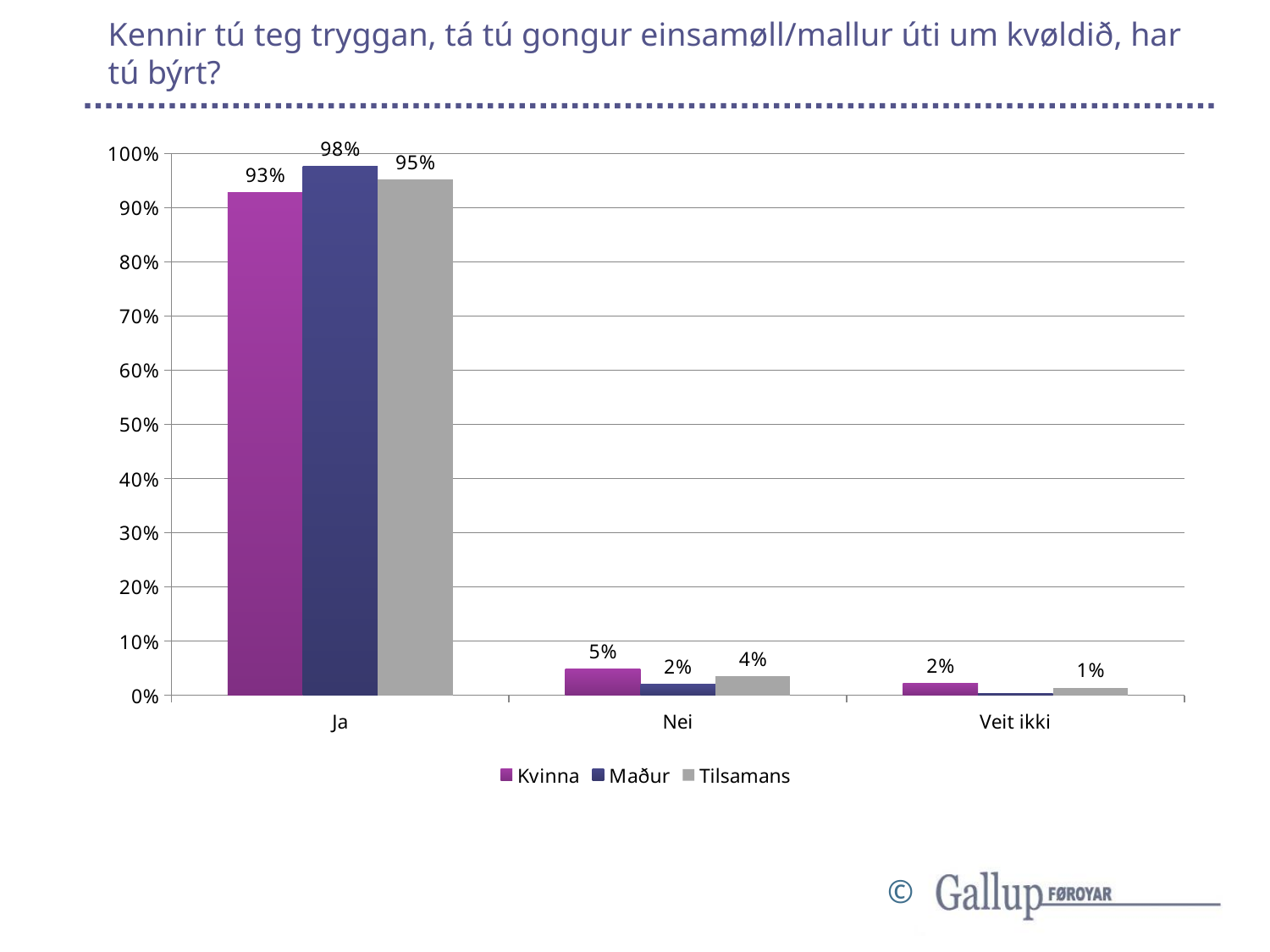
Which series has the highest value in the Ja category? Maður What is the value for Tilsamans in the Nei category? 4% What kind of chart is shown on the slide? bar chart What is the value for Maður in the Ja category? 98% Is the value for Kvinna in the Ja category greater or less than 90%? greater What is the value for Kvinna in the Ja category? 93% What is the value for Kvinna in the Veit ikki category? 2% Which category has the lowest value for Tilsamans? Veit ikki Which is larger in the Nei category, Kvinna or Maður? Kvinna How many series does the legend list? 3 What is the difference between the Maður and Kvinna values in the Ja category? 5% How many categories are shown on the x axis? 3